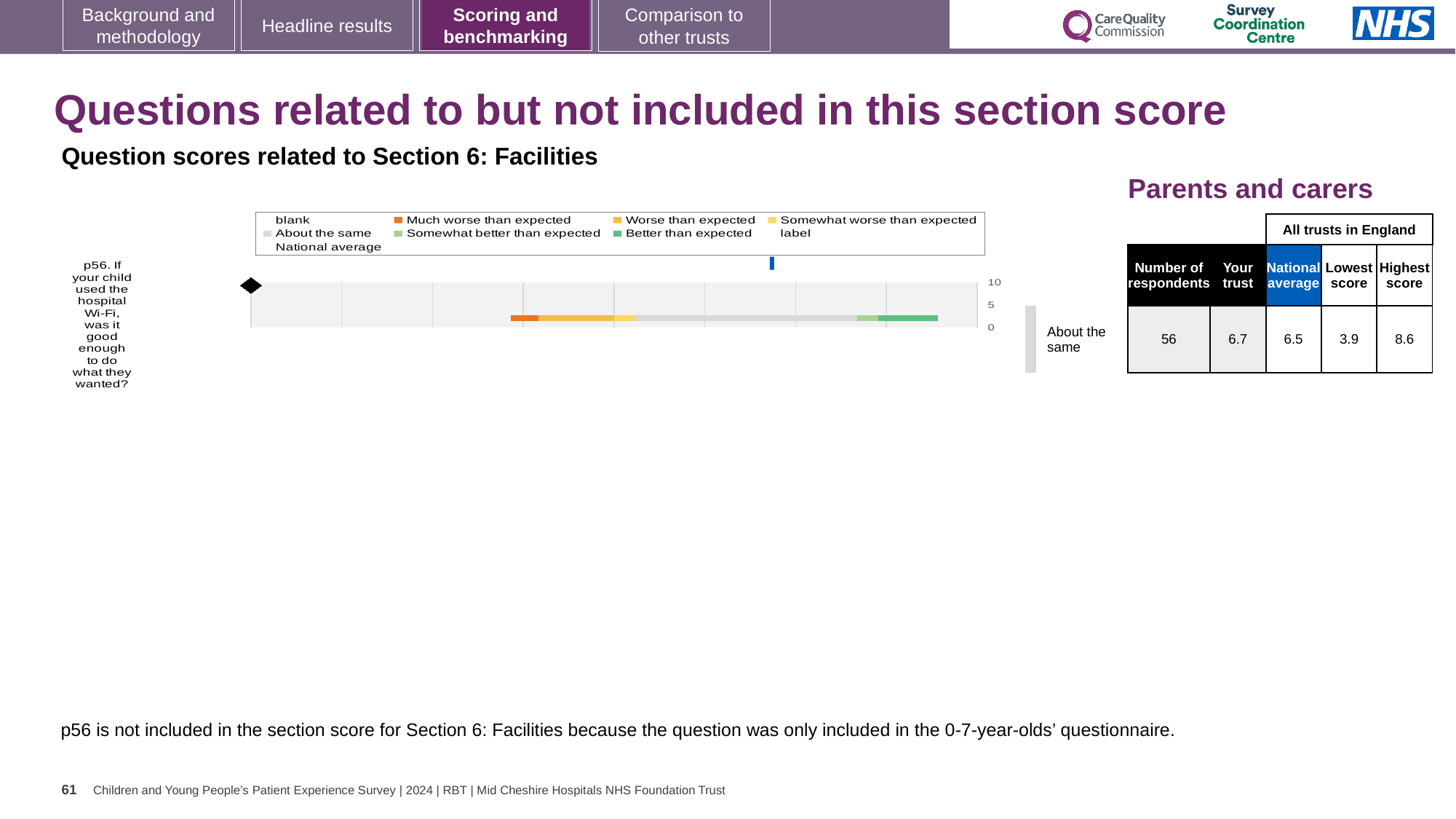
What kind of chart is shown on the slide? bar chart What is the highest value shown on the chart's axis? 10 Which question is plotted in the chart? p56. If your child used the hospital Wi-Fi, was it good enough to do what they wanted? Is the trust's score for p56 greater or less than 10? less Which legend entry is shown in orange? Much worse than expected What is the difference between the highest score and the lowest score for p56? 4.7 What is the national average score for p56? 6.5 Is the trust's score for p56 greater or less than 5? greater Which benchmark category is the trust's result for p56 placed in? About the same How many questions are plotted in the chart? 1 What is the 'Your trust' score for p56? 6.7 How many entries does the chart legend list? 9